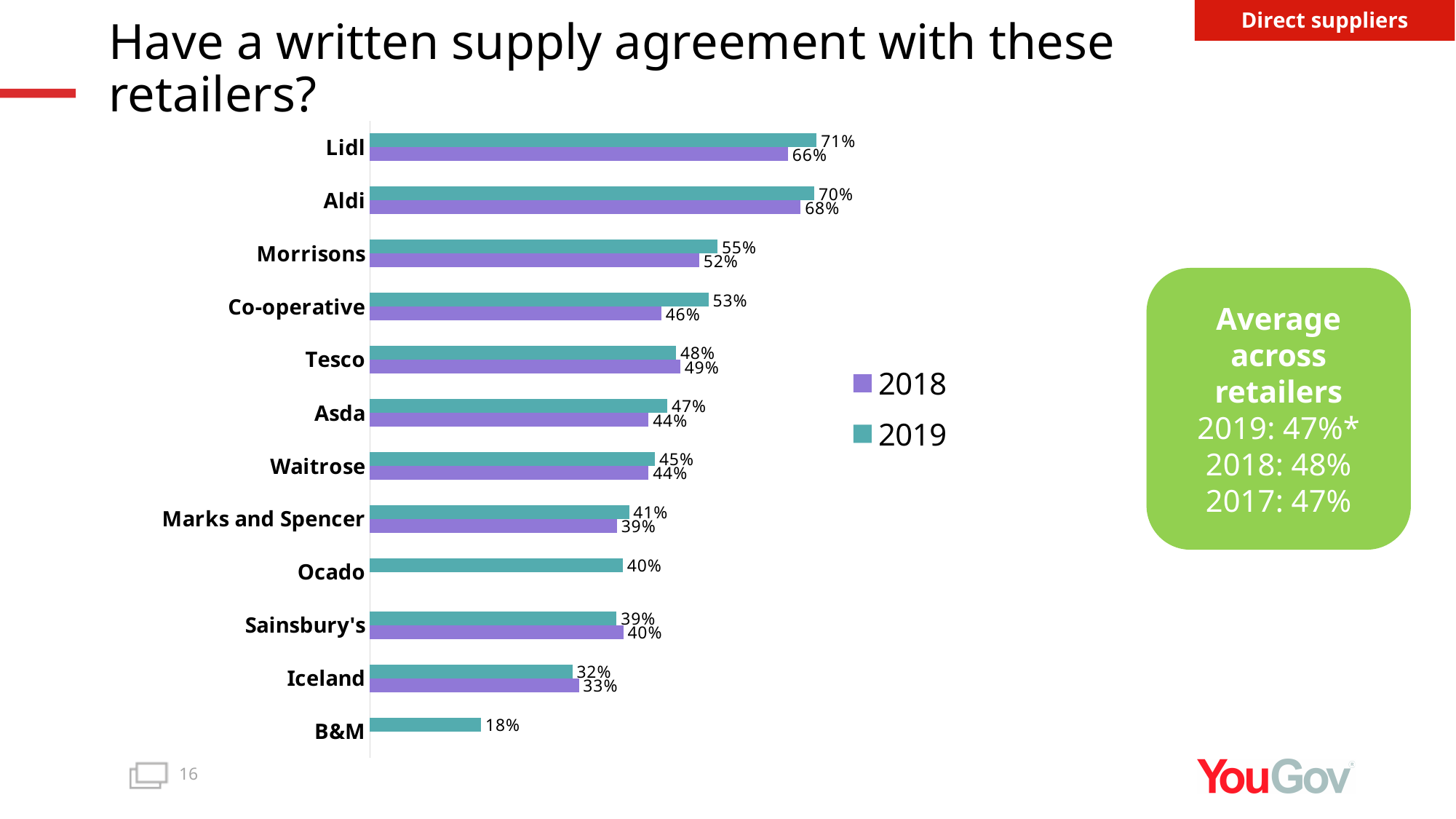
What is the 2019 value for Lidl? 71% How many series does the legend list? 2 What is the difference between the 2019 values for Aldi and Morrisons? 15% Which is larger for Tesco, the 2018 value or the 2019 value? 2018 What kind of chart is shown on the slide? Bar chart What is the difference between the 2019 and 2018 values for Co-operative? 7% Which retailer has the lowest 2019 value? B&M How many retailers are listed on the chart? 12 Which retailer has the highest 2019 value? Lidl Which colour represents 2019 in the legend? Teal What is the 2019 value for Ocado? 40% What is the 2018 value for Co-operative? 46%